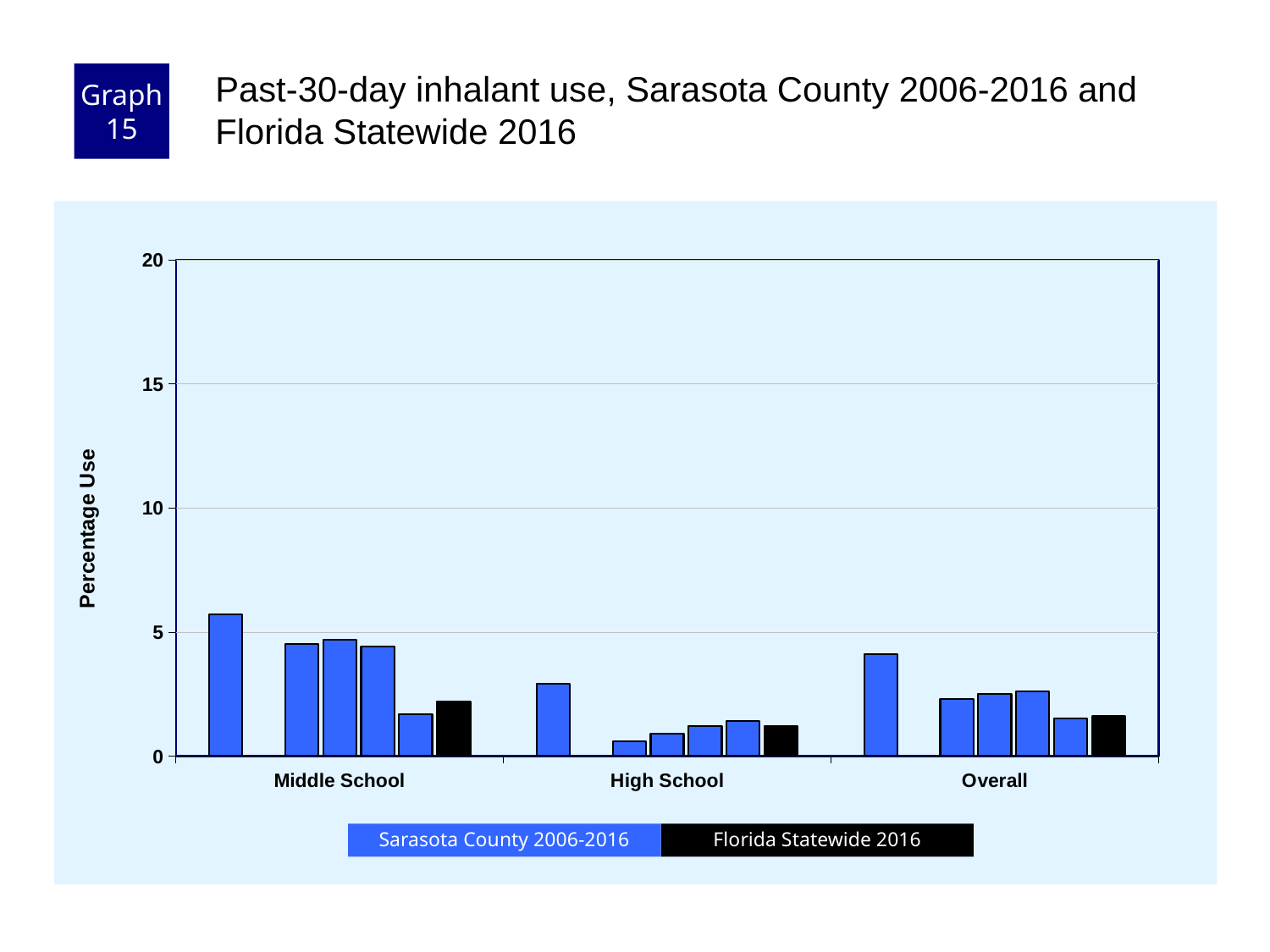
Which category group contains the shortest bar on the chart? High School What is the label on the y axis? Percentage Use Which is larger, the Florida Statewide 2016 value for Middle School or for High School? Middle School How many series does the legend list? 2 Which is larger, the Florida Statewide 2016 value for Middle School or for Overall? Middle School What kind of chart is shown on the slide? bar chart Is the Florida Statewide 2016 value for Middle School greater or less than 5? less Is the Florida Statewide 2016 value for High School greater or less than 5? less Which series is shown in black in the legend? Florida Statewide 2016 Which category group contains the tallest bar on the chart? Middle School How many categories are shown along the x axis? 3 Is the tallest Sarasota County bar in the Middle School group greater or less than 5? greater